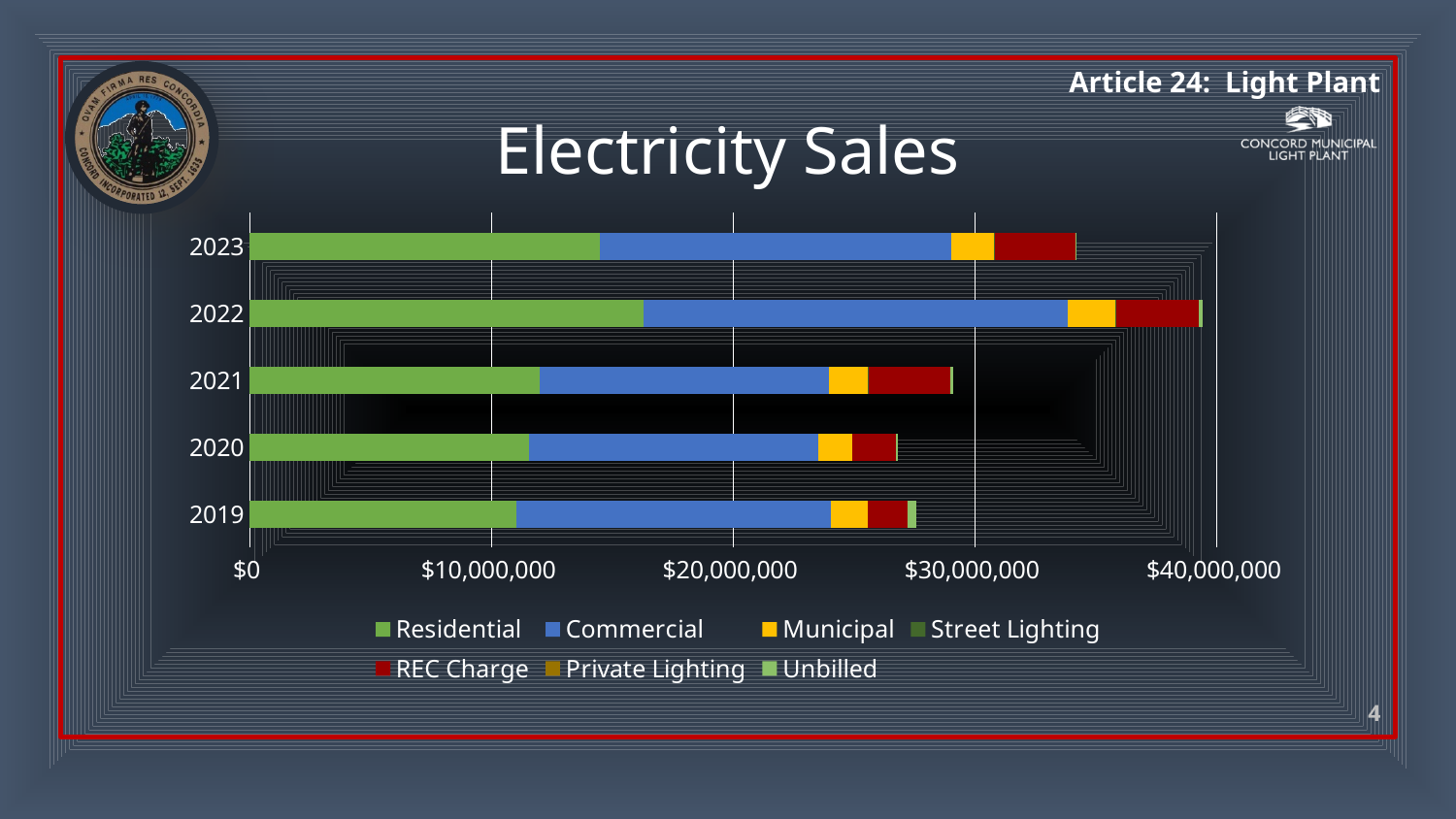
What is the title of the chart? Electricity Sales What kind of chart is shown on the slide? Stacked bar chart Do total electricity sales rise or fall from 2021 to 2022? rise How many series does the legend list? 7 What colour represents the Commercial series in the chart? Blue Which year has the highest total electricity sales? 2022 Which year has the larger total electricity sales, 2022 or 2023? 2022 Is the Residential value for 2022 greater or less than $10,000,000? greater How many years are shown on the chart? 5 Is the total electricity sales for 2022 greater or less than $30,000,000? greater Is the total electricity sales for 2019 greater or less than $30,000,000? less